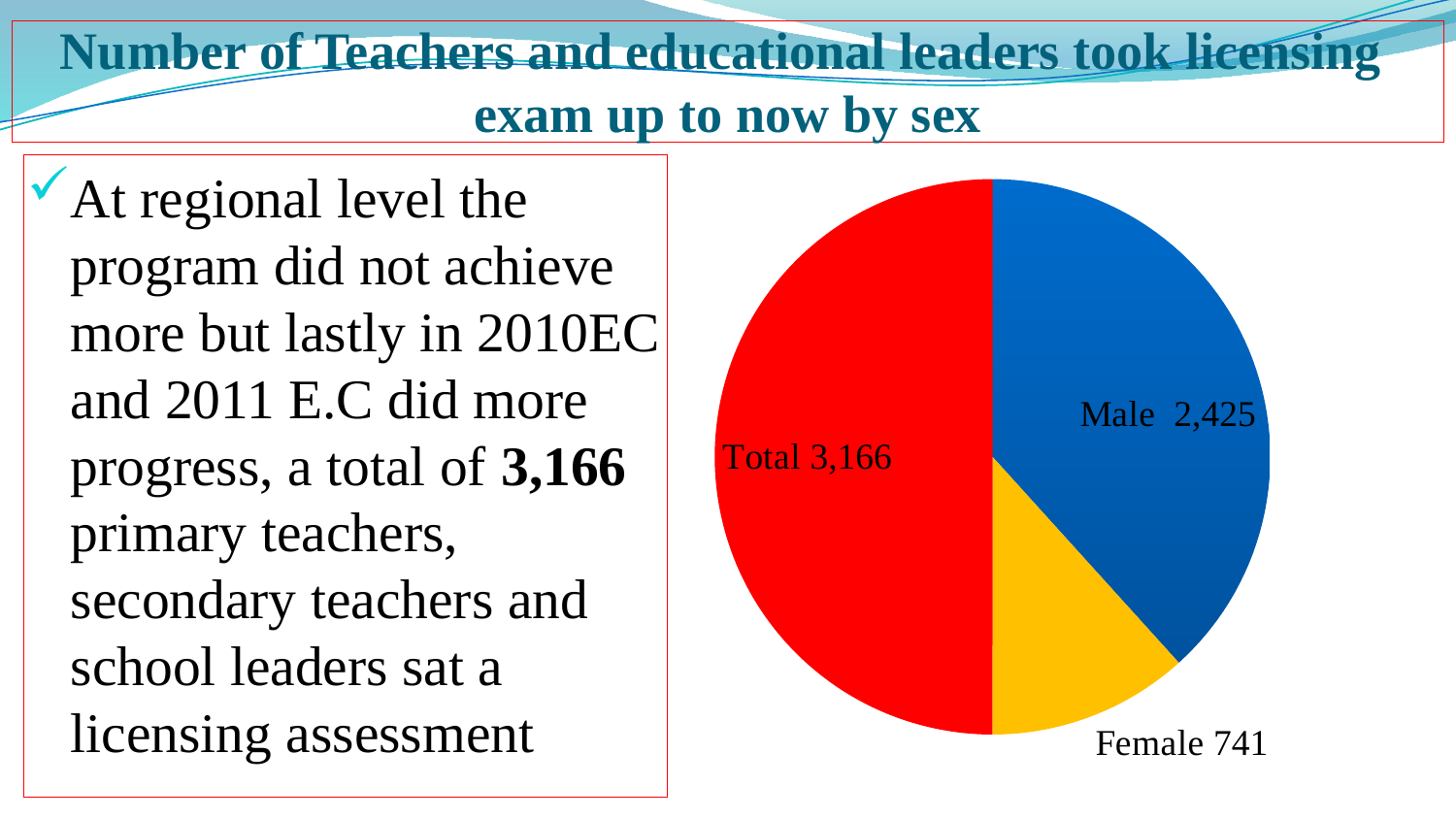
What kind of chart is shown on the slide? pie chart What value is shown for the Total slice in the pie chart? 3,166 Which slice of the pie chart is the smallest? Female Which is larger in the pie chart, Male or Female? Male What is the difference between the Male and Female values in the pie chart? 1,684 What colour is the Male slice in the pie chart? blue How many slices does the pie chart have? 3 What is the value shown for Male in the pie chart? 2,425 What is the value shown for Female in the pie chart? 741 Which slice of the pie chart is the largest? Total What colour is the Female slice in the pie chart? yellow What is the difference between the Total value and the Male value in the pie chart? 741